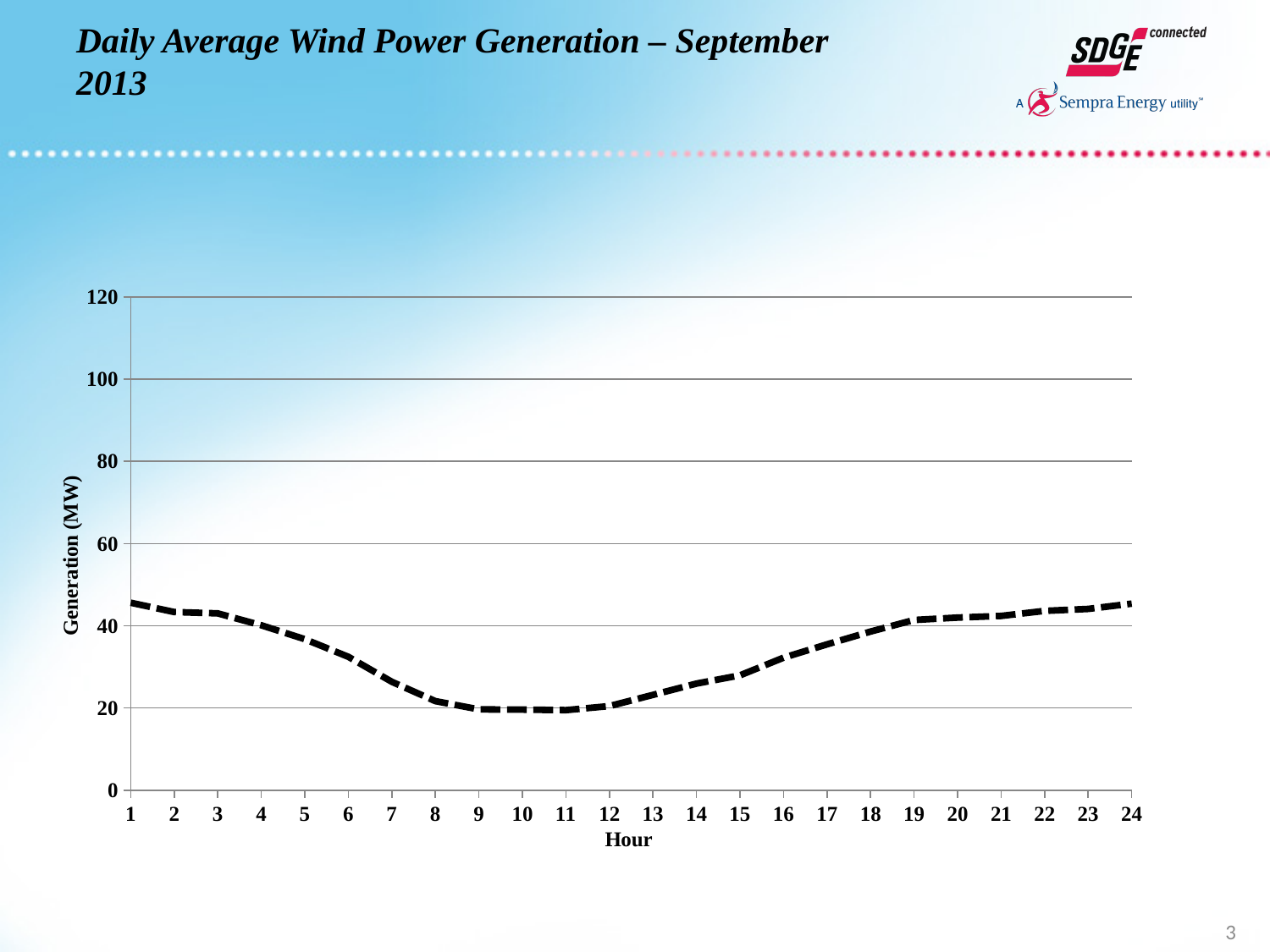
Is the generation at hour 10 greater or less than 40 MW? less Does generation rise or fall from hour 11 to hour 24? rise Is the generation at hour 24 greater or less than 40 MW? greater Which hour has higher generation, hour 3 or hour 13? hour 3 Is the generation at hour 1 greater or less than 40 MW? greater Does generation rise or fall from hour 1 to hour 10? fall How many hours are plotted along the x axis? 24 What kind of chart is shown on the slide? line chart What is the label on the vertical axis? Generation (MW) Which hour has higher generation, hour 1 or hour 10? hour 1